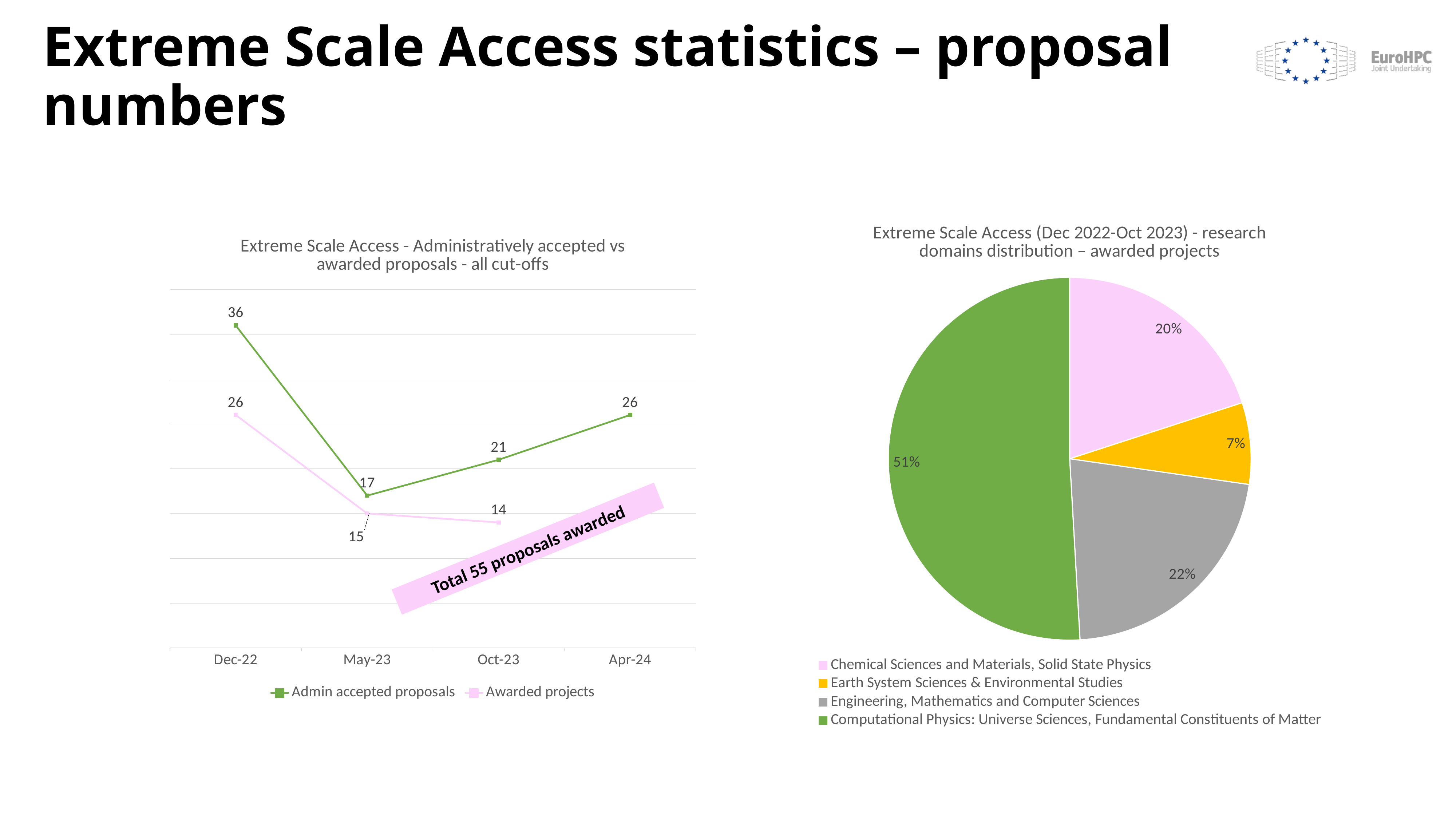
In the left chart, what is the difference between Admin accepted proposals and Awarded projects at Oct-23? 7 In the right pie chart, how many research domains are shown? 4 In the left chart, what is the value of Admin accepted proposals for Apr-24? 26 In the right pie chart, what share is Engineering, Mathematics and Computer Sciences? 22% What type of chart is the left chart? Line chart In the right pie chart, which research domain has the largest share? Computational Physics: Universe Sciences, Fundamental Constituents of Matter In the left chart, what is the value of Admin accepted proposals for Dec-22? 36 In the left chart, what is the value of Awarded projects for May-23? 15 In the left chart, which is larger: Admin accepted proposals at Oct-23 or at Apr-24? Apr-24 In the left chart, how many series does the legend list? 2 In the right pie chart, which research domain has the smallest share? Earth System Sciences & Environmental Studies In the left chart, at which cut-off is the number of Admin accepted proposals lowest? May-23